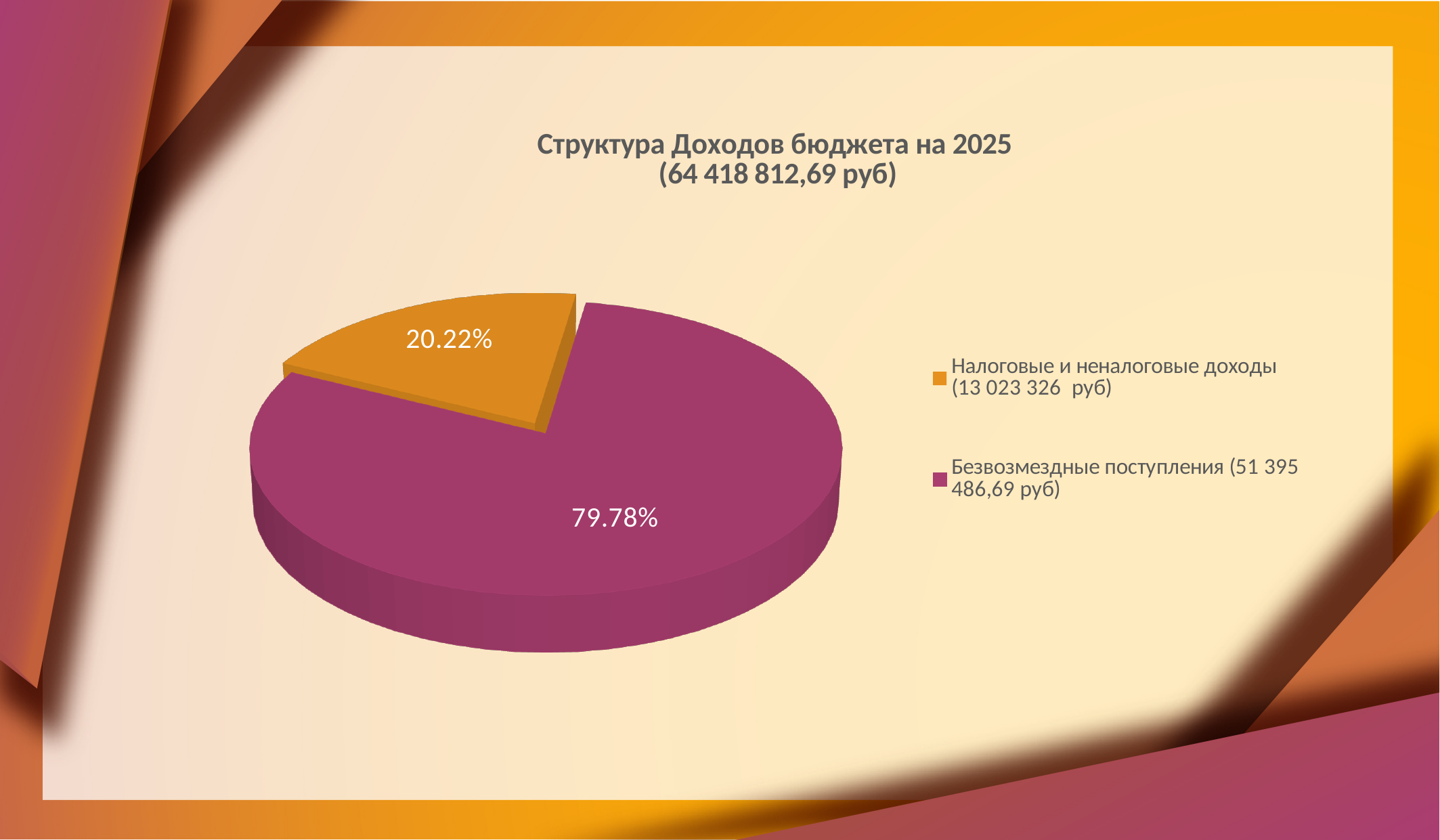
What amount in rubles is given in the legend for Налоговые и неналоговые доходы? 13 023 326 руб How many slices does the pie chart have? 2 Which is larger: the share for Безвозмездные поступления or the share for Налоговые и неналоговые доходы? Безвозмездные поступления Which category has the largest share of the pie? Безвозмездные поступления What share of the pie is labelled for Налоговые и неналоговые доходы? 20.22% What is the title of the chart? Структура Доходов бюджета на 2025 (64 418 812,69 руб) What share of the pie is labelled for Безвозмездные поступления? 79.78% What colour is the slice for Налоговые и неналоговые доходы? orange What kind of chart is shown on the slide? pie chart Which category has the smallest share of the pie? Налоговые и неналоговые доходы What amount in rubles is given in the legend for Безвозмездные поступления? 51 395 486,69 руб What is the difference in percentage points between the two slices of the pie? 59.56